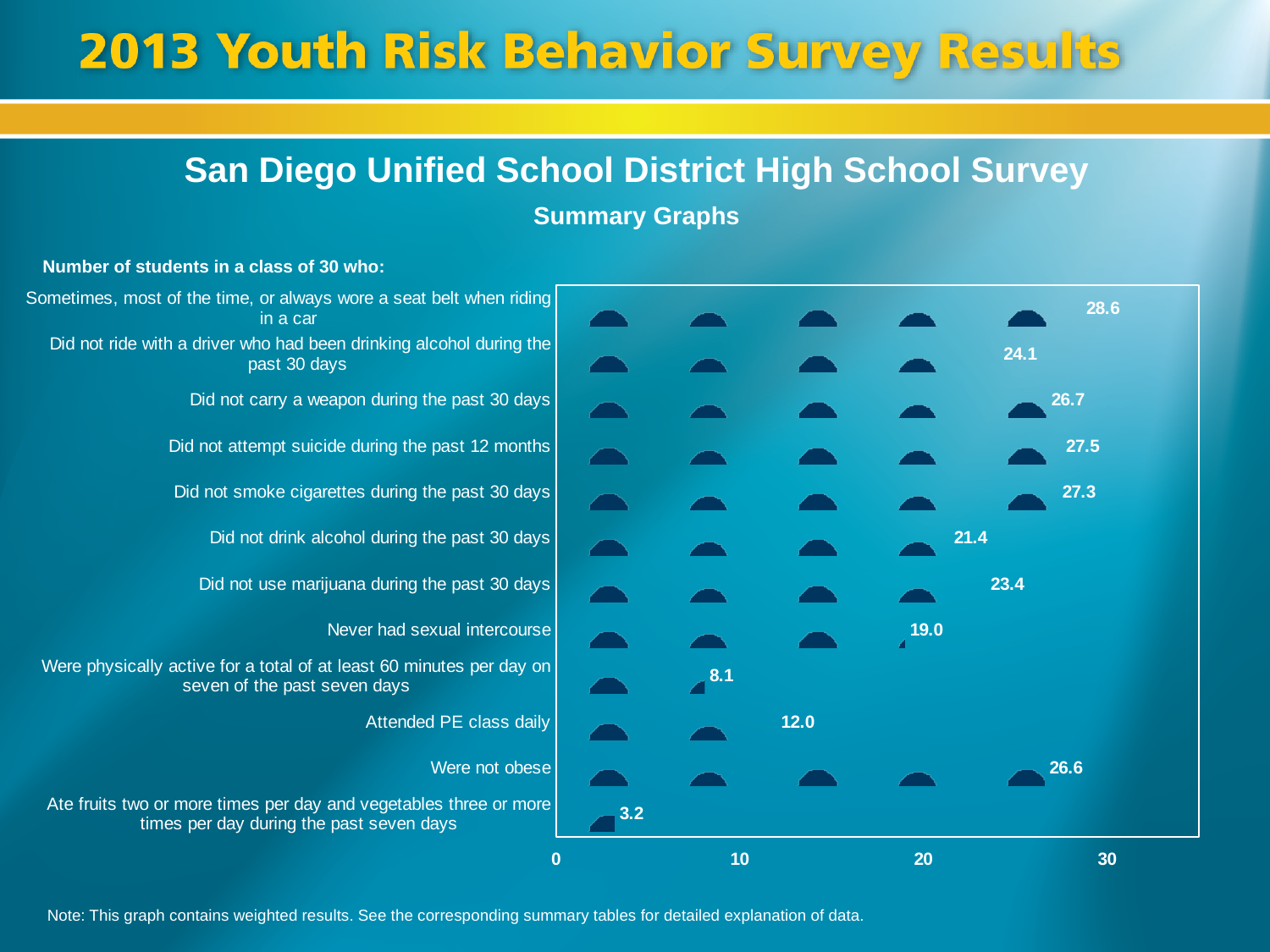
Which is larger: the value for 'Did not smoke cigarettes during the past 30 days' or the value for 'Did not drink alcohol during the past 30 days'? Did not smoke cigarettes during the past 30 days What kind of chart is shown on the slide? bar chart How many categories are shown in the chart? 12 What is the difference between the value for 'Attended PE class daily' and the value for 'Were physically active for a total of at least 60 minutes per day on seven of the past seven days'? 3.9 Is the value for 'Were not obese' greater or less than 20? greater What is the difference between the value for 'Did not ride with a driver who had been drinking alcohol during the past 30 days' and the value for 'Did not drink alcohol during the past 30 days'? 2.7 What is the value for 'Attended PE class daily'? 12.0 Which category has the highest value? Sometimes, most of the time, or always wore a seat belt when riding in a car What is the value for 'Did not use marijuana during the past 30 days'? 23.4 What is the value for 'Never had sexual intercourse'? 19.0 Which category has the lowest value? Ate fruits two or more times per day and vegetables three or more times per day during the past seven days What is the value for 'Did not carry a weapon during the past 30 days'? 26.7